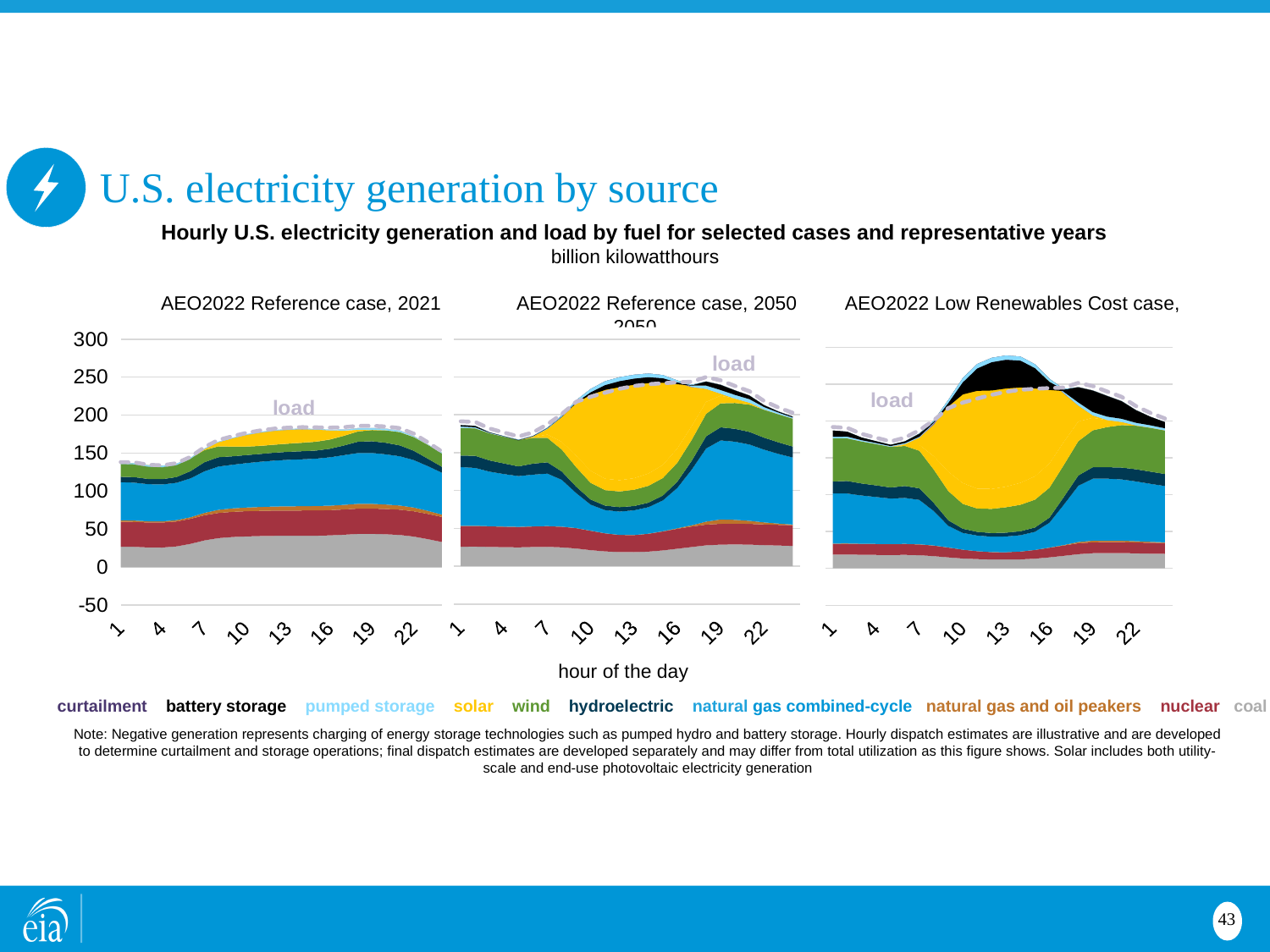
In the AEO2022 Low Renewables Cost case chart, is the peak total generation around hour 13 greater or less than 250? greater Which chart shows a larger coal contribution: AEO2022 Reference case, 2021 or AEO2022 Low Renewables Cost case? AEO2022 Reference case, 2021 In the AEO2022 Reference case, 2021 chart, does load rise or fall from hour 1 to hour 13? rise What kind of chart is used on this slide? stacked area chart How many fuel/source series does the legend list? 10 What is the x-axis label shared by the three charts? hour of the day In the AEO2022 Reference case, 2021 chart, is the total generation at hour 1 greater or less than 100? greater In the AEO2022 Reference case, 2050 chart, is the peak load greater or less than 200? greater How many charts are shown on the slide? 3 What unit is the y axis measured in? billion kilowatthours Which chart shows a larger solar contribution at midday: AEO2022 Reference case, 2021 or AEO2022 Reference case, 2050? AEO2022 Reference case, 2050